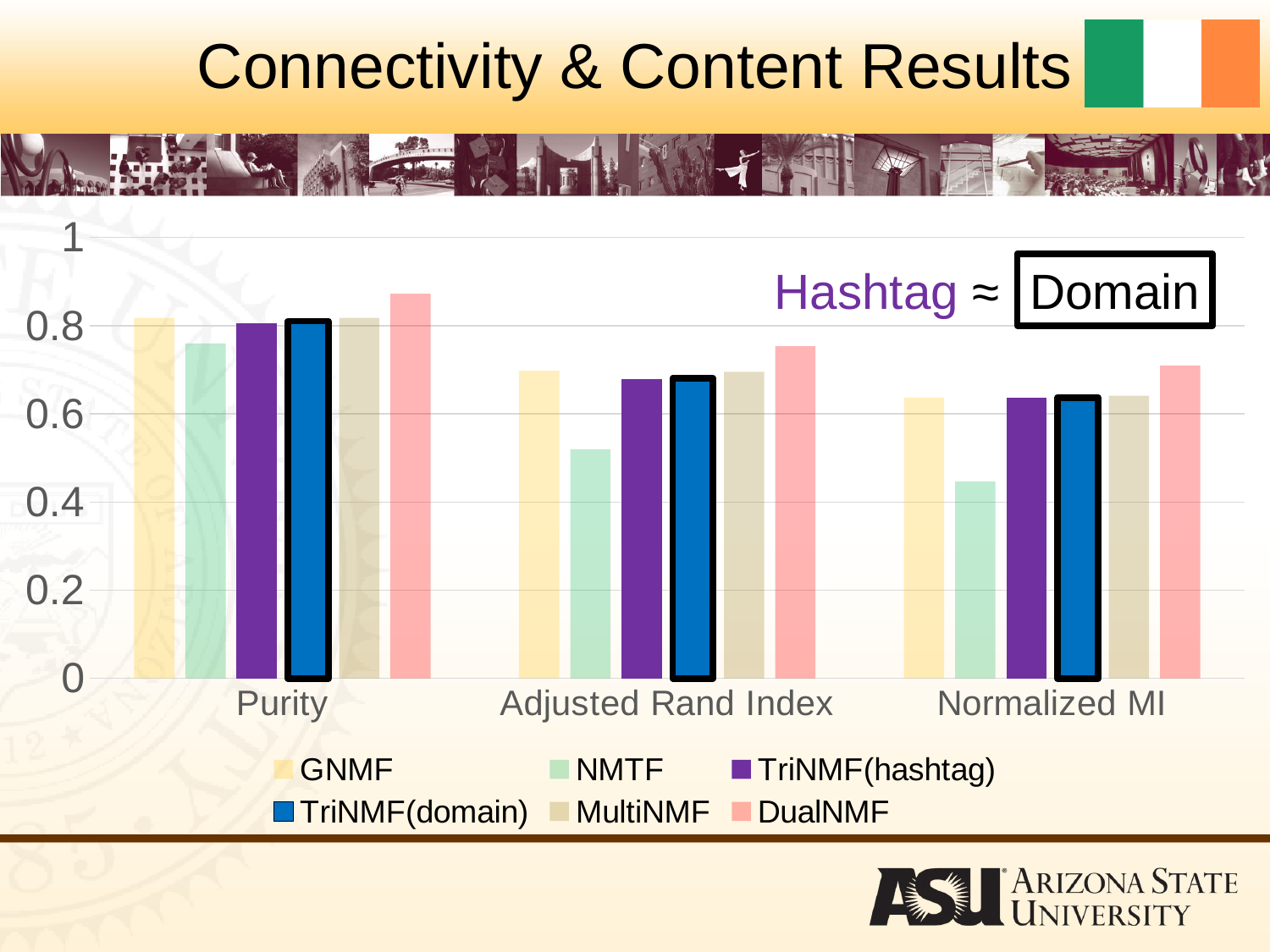
Is the value for NMTF on Adjusted Rand Index greater or less than 0.4? greater Which series is drawn with a thick black outline around its bars? TriNMF(domain) Is the value for DualNMF on Purity greater or less than 0.8? greater Which series has the highest value for Purity? DualNMF Which is larger for Adjusted Rand Index: DualNMF or NMTF? DualNMF Is the value for NMTF on Normalized MI greater or less than 0.6? less How many categories are shown on the x axis? 3 Which series has the highest value for Normalized MI? DualNMF What kind of chart is shown on the slide? bar chart Which series has the lowest value for Normalized MI? NMTF How many series does the legend list? 6 Which series has the lowest value for Adjusted Rand Index? NMTF